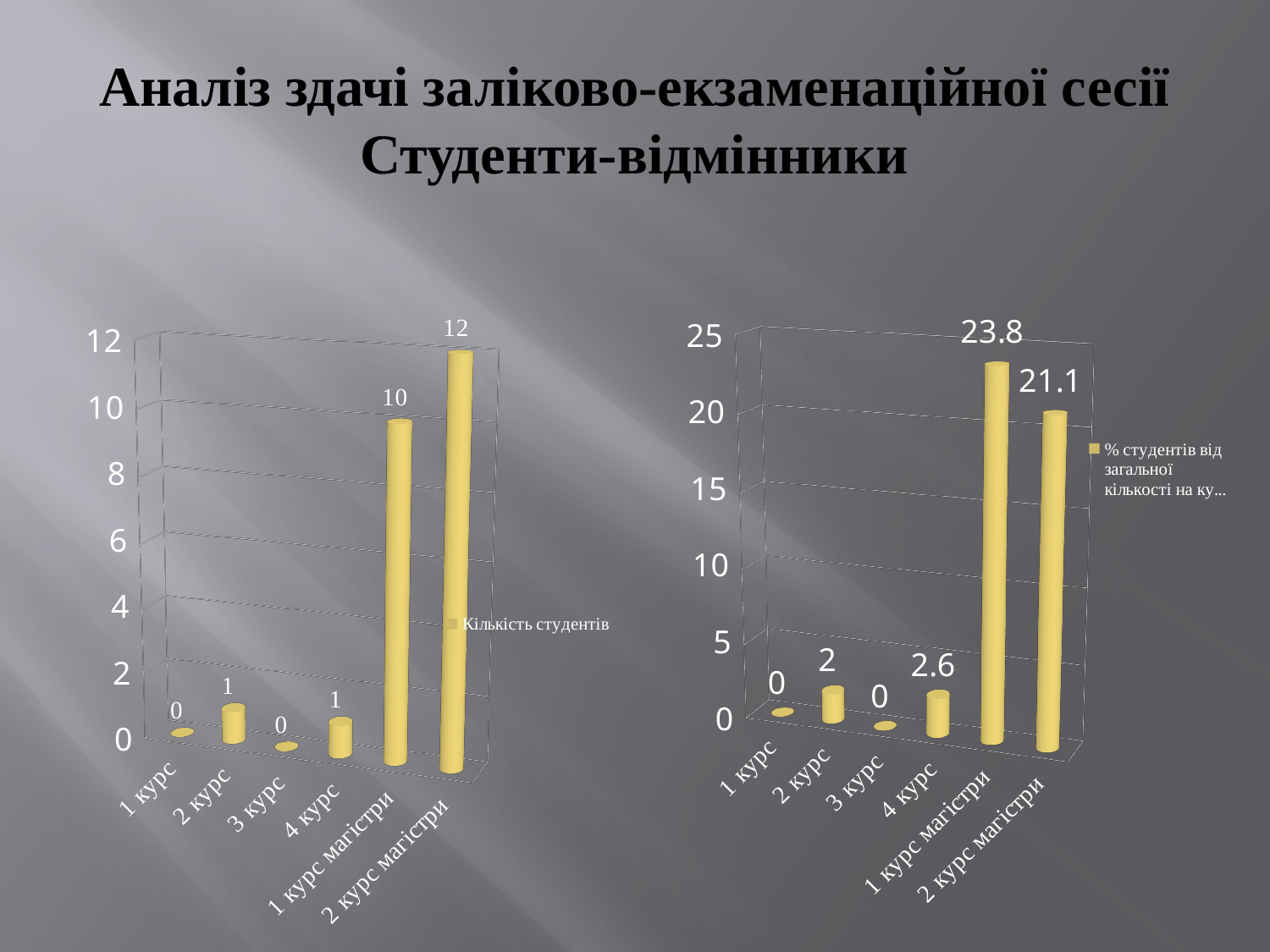
In the right chart, what is the value for 4 курс? 2.6 In the left chart, what is the difference between the values for 2 курс магістри and 1 курс магістри? 2 In the left chart, what is the value for 1 курс магістри? 10 How many categories are shown on the x axis of the left chart? 6 In the right chart, which category has the highest value? 1 курс магістри In the right chart, which is larger, the value for 2 курс or the value for 4 курс? 4 курс In the left chart, which category has the highest value? 2 курс магістри What kind of chart is the right chart? bar chart In the left chart, what is the value for 2 курс магістри? 12 In the right chart, what is the difference between the values for 1 курс магістри and 2 курс магістри? 2.7 In the right chart, what is the value for 1 курс магістри? 23.8 What is the legend entry of the left chart? Кількість студентів